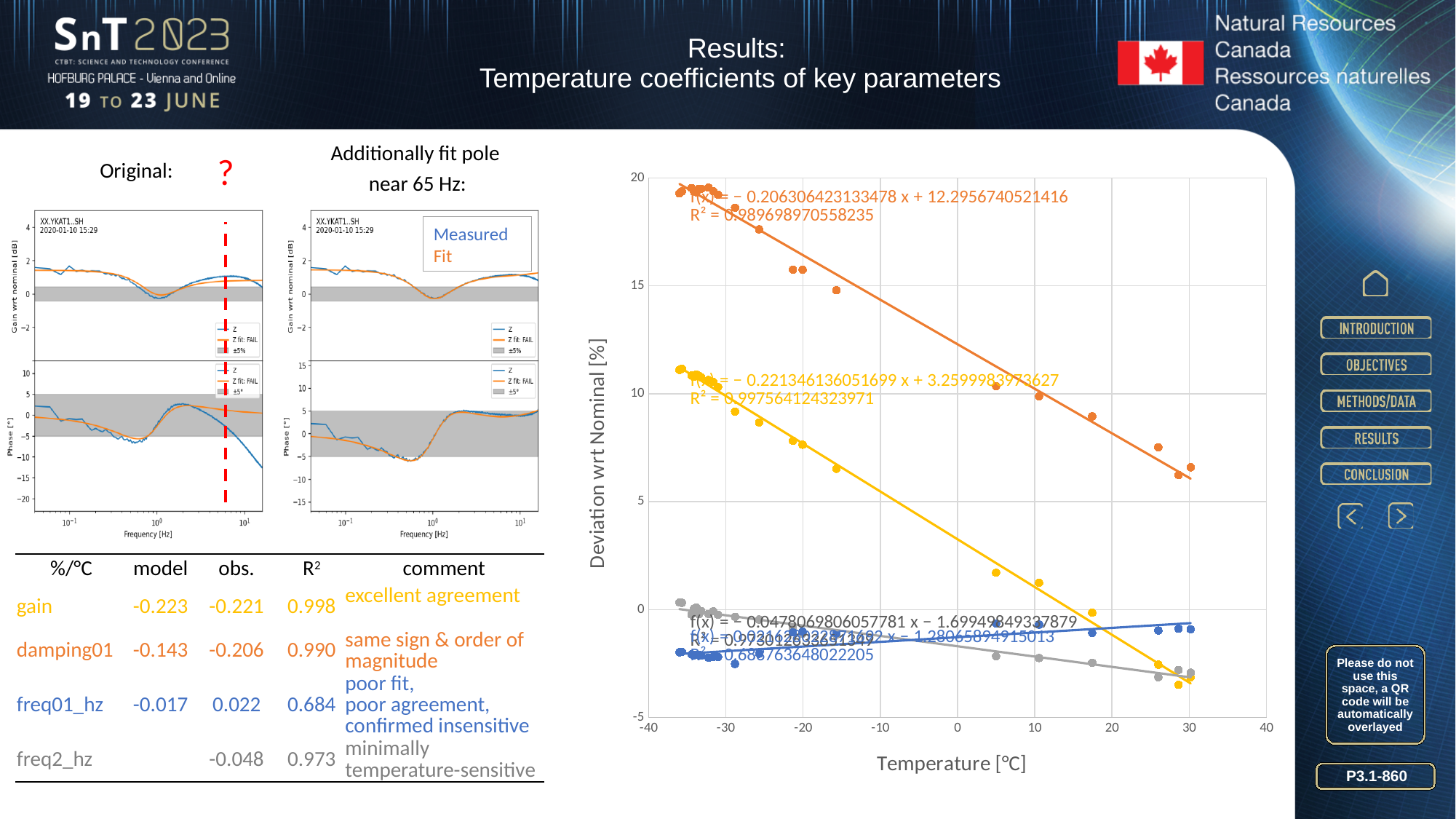
What kind of chart is the large chart on the right of the slide? scatter chart In the large scatter chart on the right, at about 30 °C, which series has the larger value: the orange series or the yellow series? orange In the large scatter chart on the right, what R² value is printed for the yellow fit line? 0.997564124323971 In the large scatter chart on the right, what is the slope printed in the equation of the orange fit line? − 0.206306423133478 In the large scatter chart on the right, is the yellow series value at about 30 °C greater or less than 0? less In the large scatter chart on the right, do the orange points rise or fall as temperature increases? fall In the large scatter chart on the right, is the orange series value at about -35 °C greater or less than 15? greater In the large scatter chart on the right, what is the label of the x axis? Temperature [°C] In the large scatter chart on the right, what R² value is printed for the orange fit line? 0.989698970558235 In the large scatter chart on the right, what is the label of the y axis? Deviation wrt Nominal [%] In the large scatter chart on the right, do the yellow points rise or fall as temperature increases? fall In the large scatter chart on the right, how many differently coloured data series are plotted? 4